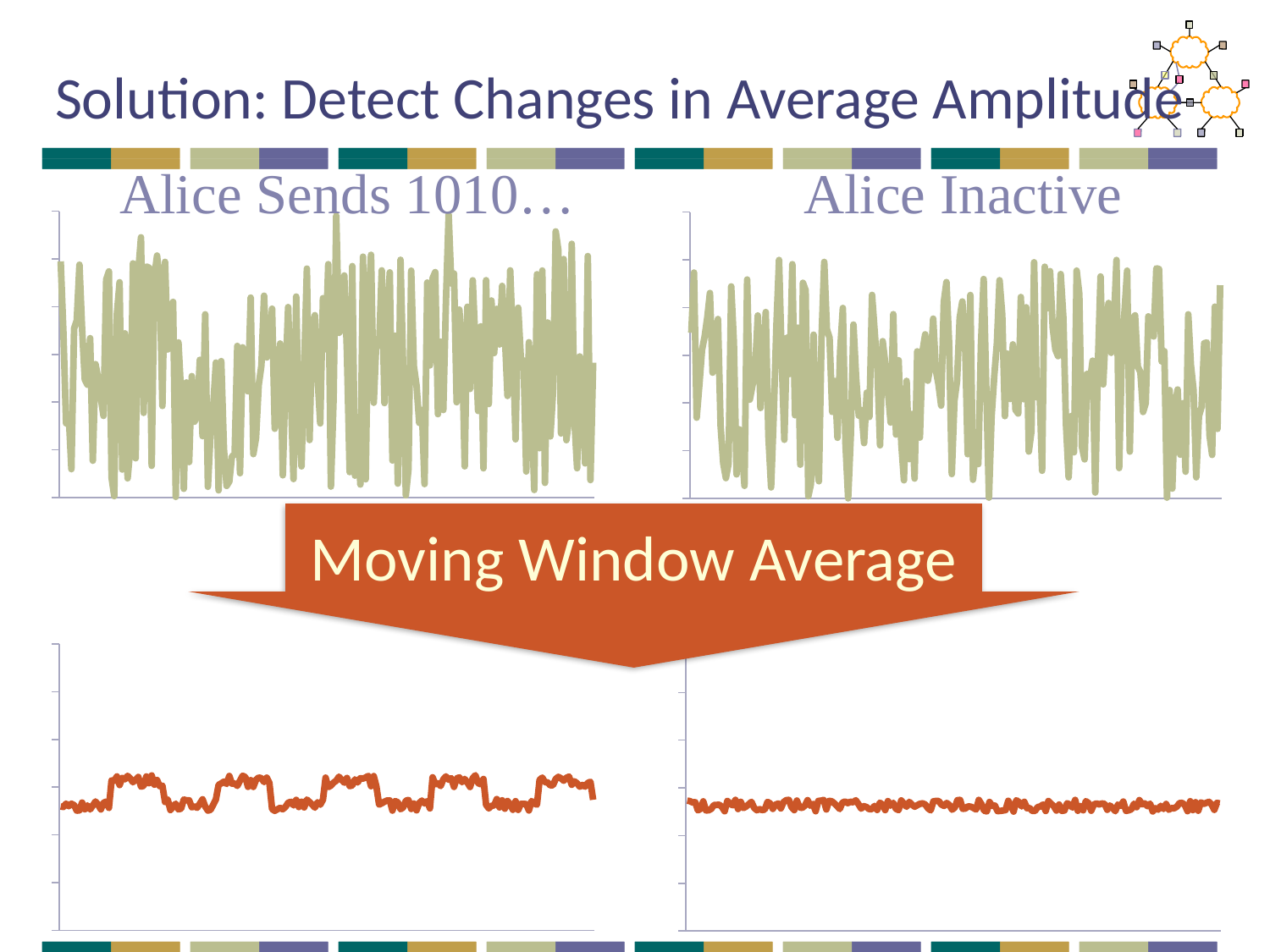
What is the title of the top-left chart? Alice Sends 1010… What kind of chart is the bottom-left chart on the slide? line chart What kind of chart is the chart titled "Alice Sends 1010…"? line chart Which of the two bottom charts shows larger swings in its line, the bottom-left or the bottom-right? bottom-left In the bottom-left chart, does the line stay flat or repeatedly switch between a low and a high level along the x axis? repeatedly switches between a low and a high level How many lines are plotted in the chart titled "Alice Inactive"? 1 How many charts are shown on the slide? 4 What kind of chart is the chart titled "Alice Inactive"? line chart In the bottom-right chart, does the line rise, fall, or stay roughly flat along the x axis? stays roughly flat